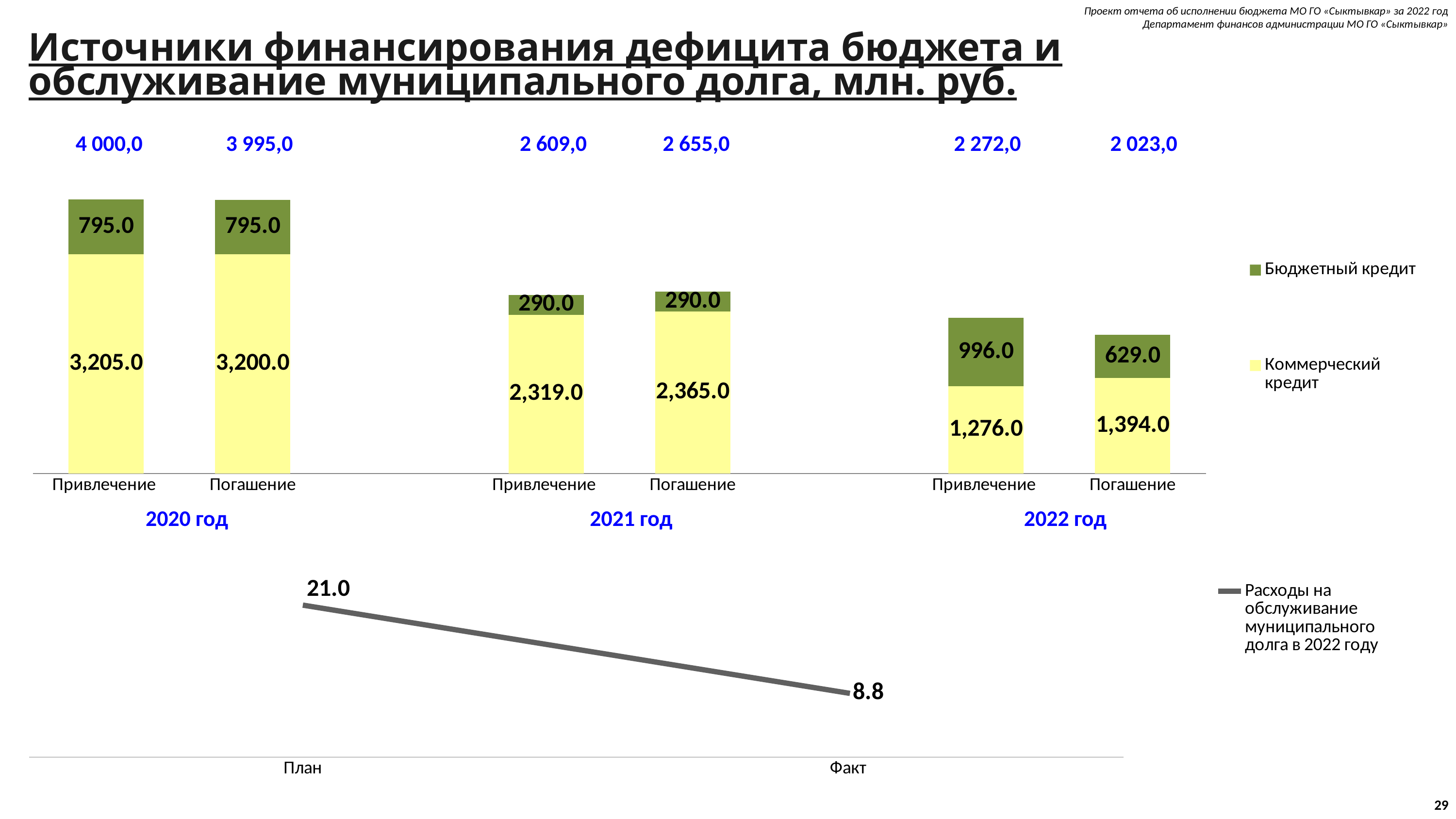
In the top stacked bar chart, what is the total shown above the Привлечение bar for 2021 год? 2 609,0 How many bars are plotted in the top chart? 6 In the top stacked bar chart, which bar has the lowest Коммерческий кредит value? Привлечение, 2022 год In the top stacked bar chart, what is the difference between the Коммерческий кредит values for Погашение and Привлечение in 2022 год? 118.0 In the top stacked bar chart, which is larger in 2022 год: Бюджетный кредит for Привлечение or for Погашение? Привлечение How many series does the legend of the top stacked bar chart list? 2 In the bottom line chart, what is the value for Факт? 8.8 In the bottom line chart, does the line rise or fall from План to Факт? Fall What kind of chart is the top chart on the slide? Stacked bar chart In the top stacked bar chart, what is the value of Коммерческий кредит for Привлечение in 2020 год? 3,205.0 In the top stacked bar chart, which bar has the highest Бюджетный кредит value? Привлечение, 2022 год In the top stacked bar chart, what is the value of Бюджетный кредит for Погашение in 2022 год? 629.0